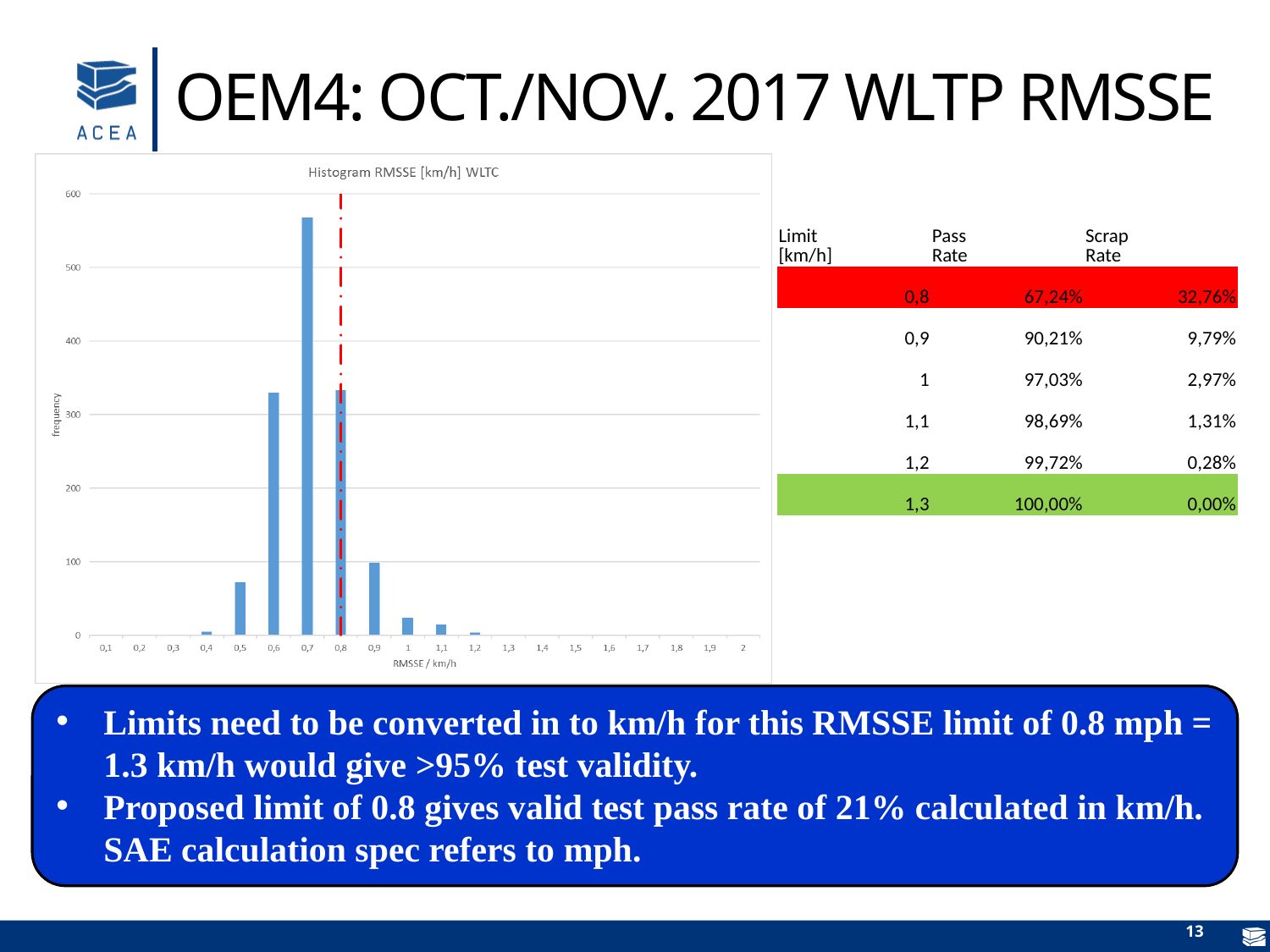
Is the frequency for RMSSE 0,7 greater or less than 500? greater Which has the higher frequency, RMSSE 0,9 or RMSSE 0,5? 0,9 Is the frequency for RMSSE 0,6 greater or less than 300? greater Which has the higher frequency, RMSSE 0,7 or RMSSE 0,6? 0,7 Is the frequency for RMSSE 0,5 greater or less than 100? less What is the label of the y axis of the chart? frequency Do the frequencies rise or fall along the x axis from RMSSE 0,7 to RMSSE 1,2? fall What is the title of the chart? Histogram RMSSE [km/h] WLTC Which RMSSE category has the highest frequency? 0,7 What kind of chart is shown on the slide? bar chart